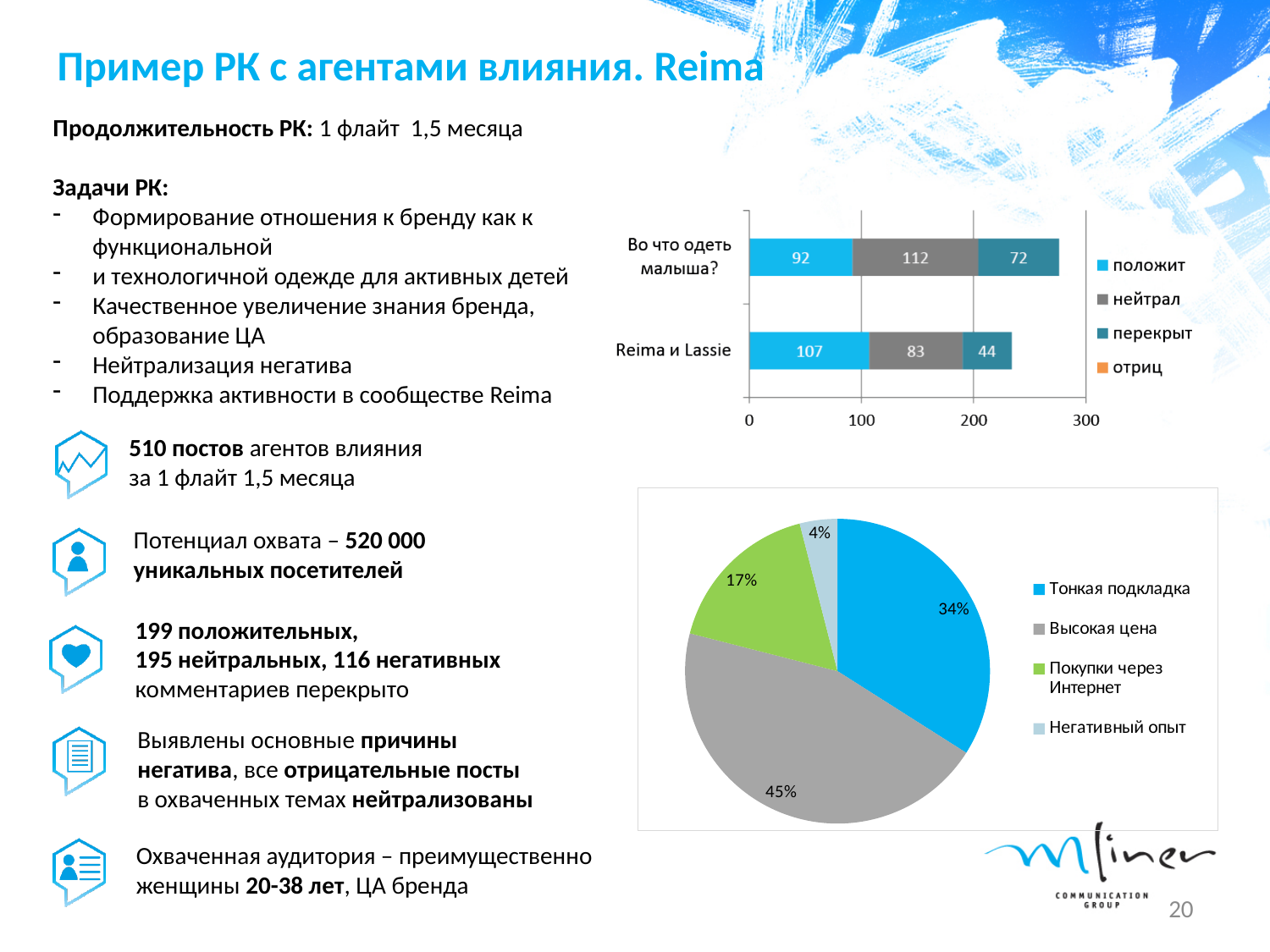
What kind of chart is the bottom-right chart on the slide? pie chart In the top-right bar chart, what is the value of 'положит' for 'Reima и Lassie'? 107 In the top-right bar chart, what is the difference between the 'перекрыт' values for 'Во что одеть малыша?' and 'Reima и Lassie'? 28 What kind of chart is the top-right chart on the slide? bar chart In the bottom-right pie chart, how many slices are there? 4 In the top-right bar chart, what is the value of 'нейтрал' for 'Во что одеть малыша?'? 112 In the bottom-right pie chart, which slice is the smallest? Негативный опыт In the top-right bar chart, how many series does the legend list? 4 In the top-right bar chart, what is the value of 'перекрыт' for 'Reima и Lassie'? 44 In the bottom-right pie chart, what share does 'Высокая цена' have? 45% In the top-right bar chart, what is the total of the stacked bar for 'Во что одеть малыша?'? 276 In the top-right bar chart, which category has the larger 'положит' value, 'Во что одеть малыша?' or 'Reima и Lassie'? Reima и Lassie